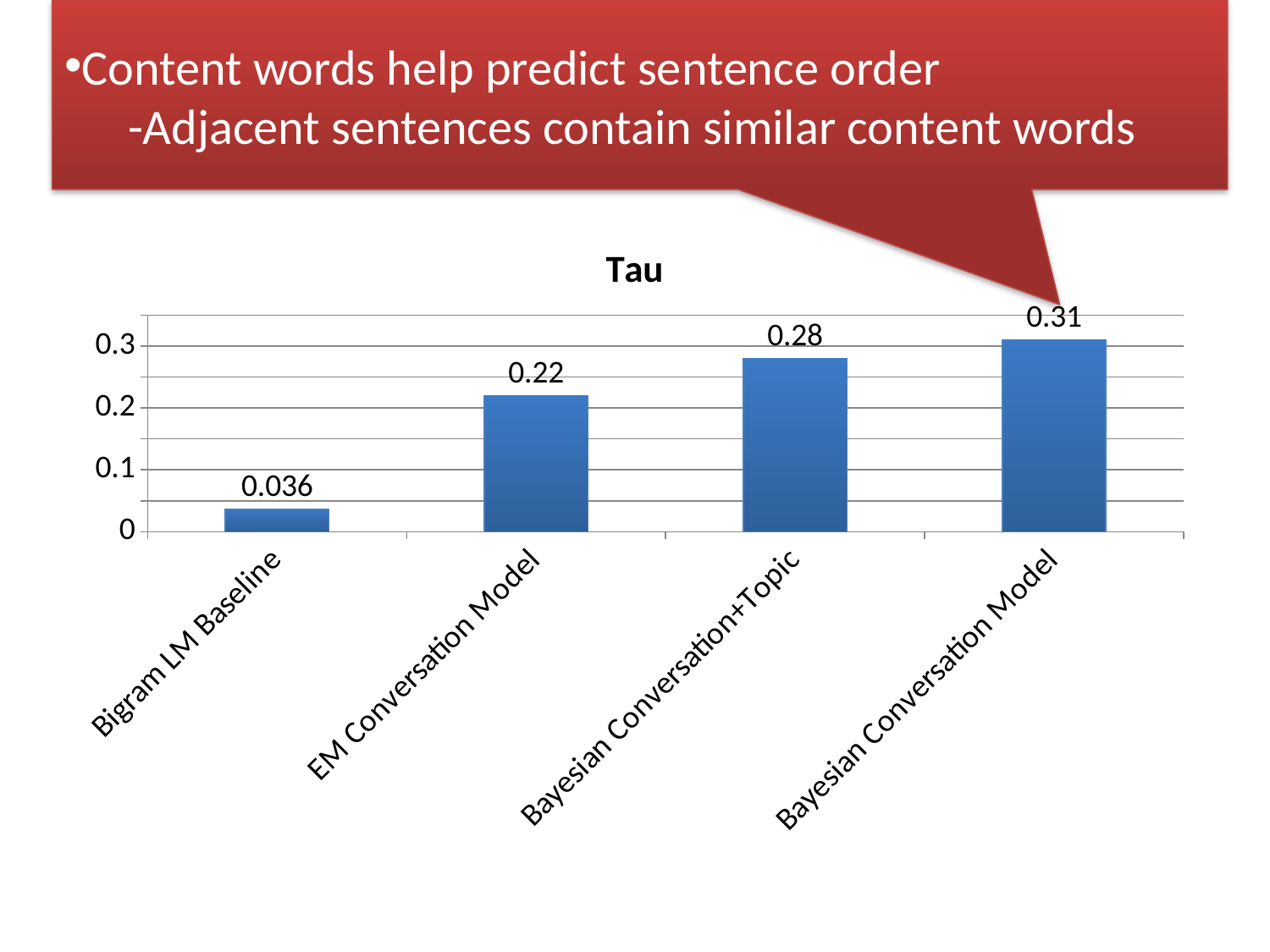
Which category has the highest Tau value? Bayesian Conversation Model What is the difference in Tau between Bayesian Conversation Model and EM Conversation Model? 0.09 What is the Tau value for Bayesian Conversation+Topic? 0.28 Is the Tau value for Bayesian Conversation Model greater or less than 0.3? greater What kind of chart is shown on the slide? bar chart Which category has the lowest Tau value? Bigram LM Baseline How many categories are shown in the chart? 4 What is the Tau value for Bayesian Conversation Model? 0.31 What is the Tau value for Bigram LM Baseline? 0.036 What is the Tau value for EM Conversation Model? 0.22 Which has a larger Tau value, EM Conversation Model or Bayesian Conversation+Topic? Bayesian Conversation+Topic What is the title of the chart? Tau